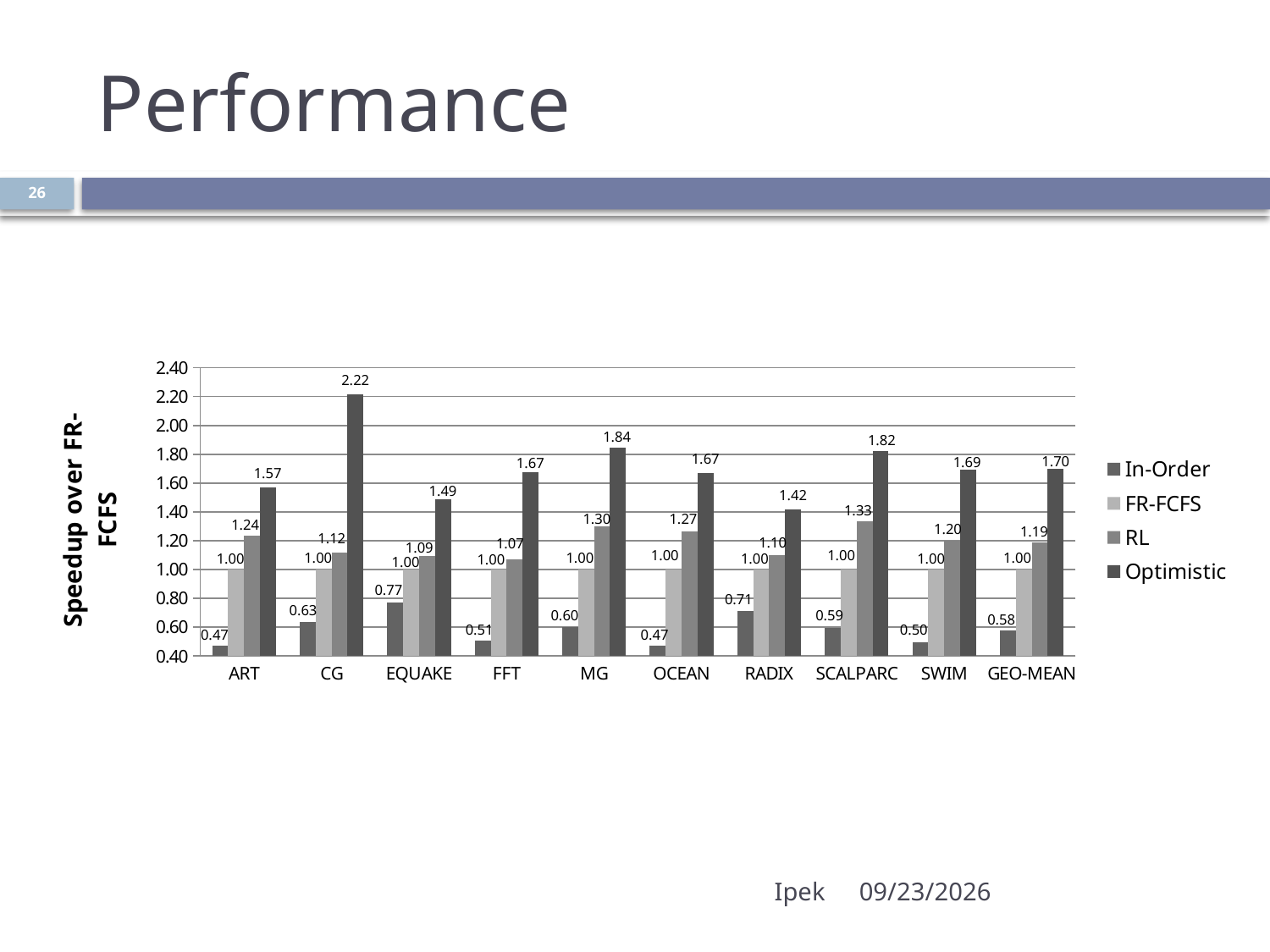
What is the RL speedup for GEO-MEAN? 1.19 What is the Optimistic speedup for CG? 2.22 What kind of chart is shown on the slide? Bar chart Which benchmark has the highest RL speedup? SCALPARC Which benchmark has the highest Optimistic speedup? CG What is the In-Order speedup for EQUAKE? 0.77 What is the label of the y axis? Speedup over FR-FCFS What is the difference between the Optimistic and In-Order speedups for CG? 1.59 Which is larger, the RL speedup for MG or the RL speedup for OCEAN? MG How many benchmarks are shown on the x axis? 10 Which benchmark has the lowest Optimistic speedup? RADIX How many series does the legend list? 4